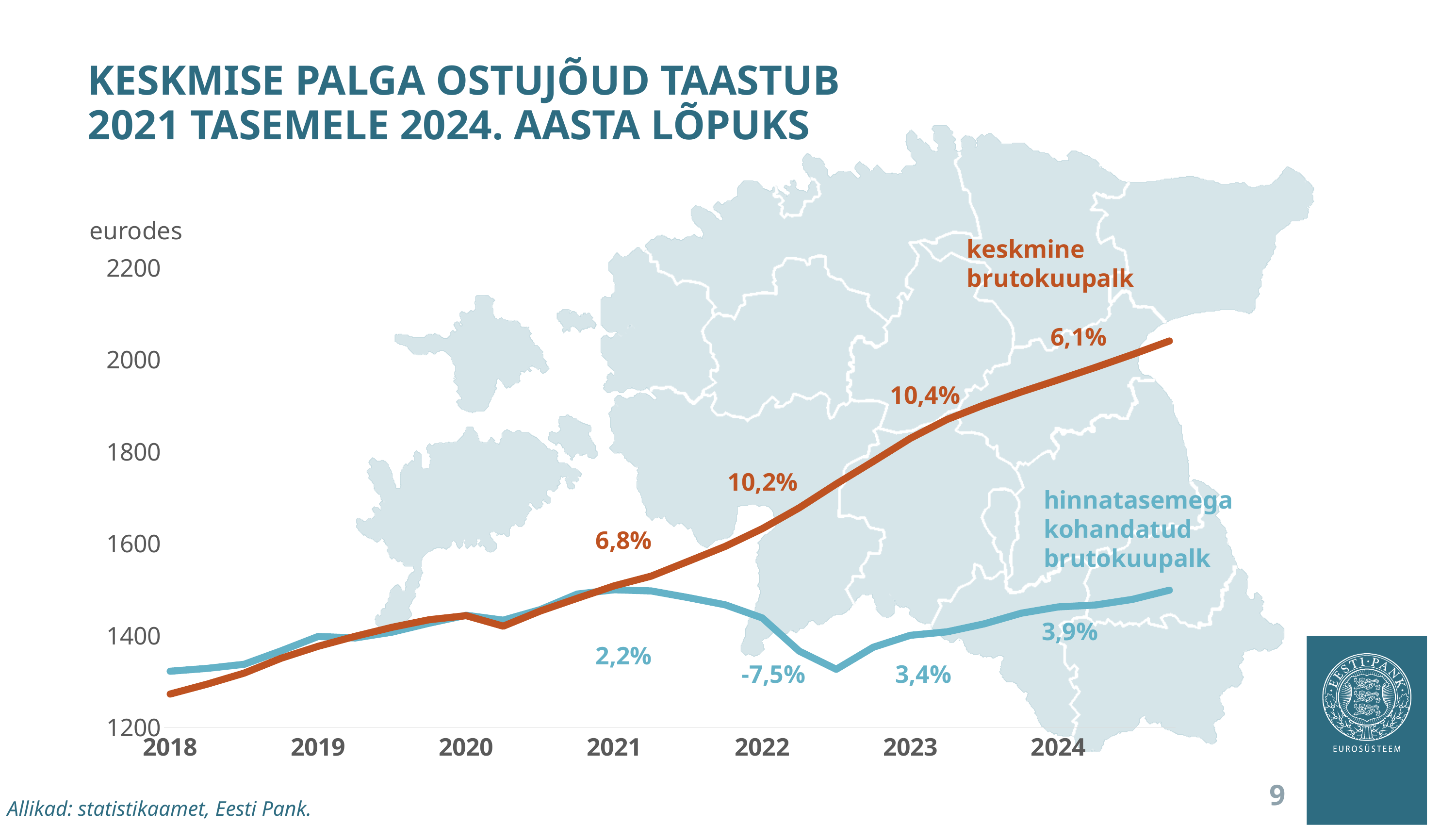
Is the value of keskmine brutokuupalk at the end of 2024 greater or less than 2000? greater Is the value of hinnatasemega kohandatud brutokuupalk at the end of 2024 greater or less than 1600? less What unit is shown on the vertical axis of the chart? eurodes What growth rate is labelled for hinnatasemega kohandatud brutokuupalk in 2022? -7,5% At the end of 2024, which series has the higher value: keskmine brutokuupalk or hinnatasemega kohandatud brutokuupalk? keskmine brutokuupalk Which year has the highest labelled growth rate for keskmine brutokuupalk? 2023 What kind of chart is shown on the slide? line chart Which year has the lowest labelled growth rate for hinnatasemega kohandatud brutokuupalk? 2022 What growth rate is labelled for keskmine brutokuupalk in 2022? 10,2% What growth rate is labelled for keskmine brutokuupalk in 2024? 6,1% How many series are plotted on the chart? 2 What growth rate is labelled for hinnatasemega kohandatud brutokuupalk in 2023? 3,4%